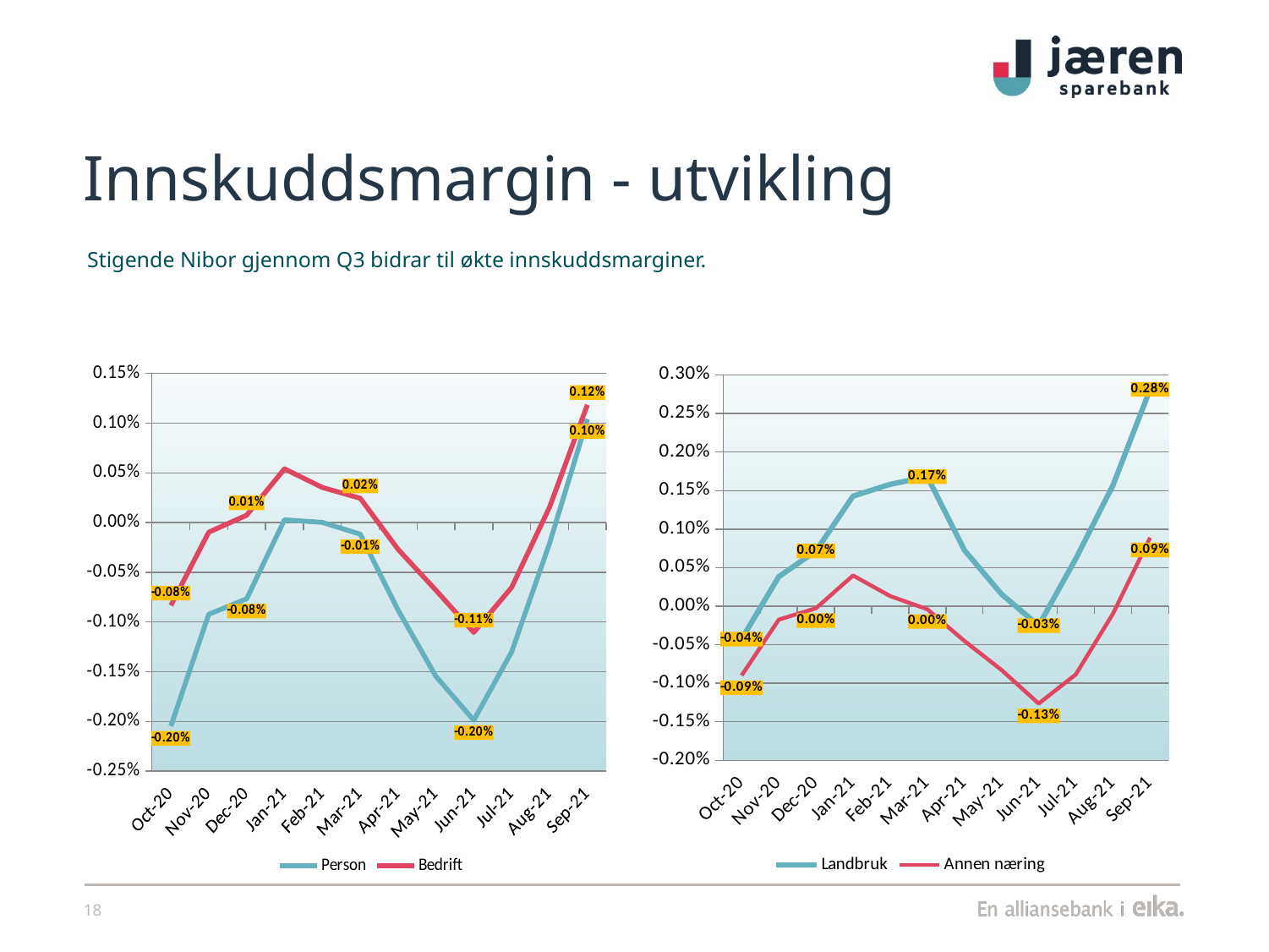
In the left chart, what is the difference between the Bedrift values in Sep-21 and Jun-21? 0.23% In the right chart, is the value for Landbruk in Jan-21 greater or less than 0.10%? greater In the right chart, what is the difference between the Landbruk and Annen næring values in Sep-21? 0.19% In the left chart, which series has the higher value in Sep-21, Person or Bedrift? Bedrift In the left chart, what is the value for Person in Sep-21? 0.10% In the right chart, what is the value for Landbruk in Mar-21? 0.17% How many months are shown on the x axis of the left chart? 12 In the right chart, which month has the highest labelled value for Landbruk? Sep-21 In the right chart, what is the value for Annen næring in Oct-20? -0.09% In the left chart, what is the value for Bedrift in Jun-21? -0.11% What type of chart is the left chart? Line chart How many series does the legend of the right chart list? 2